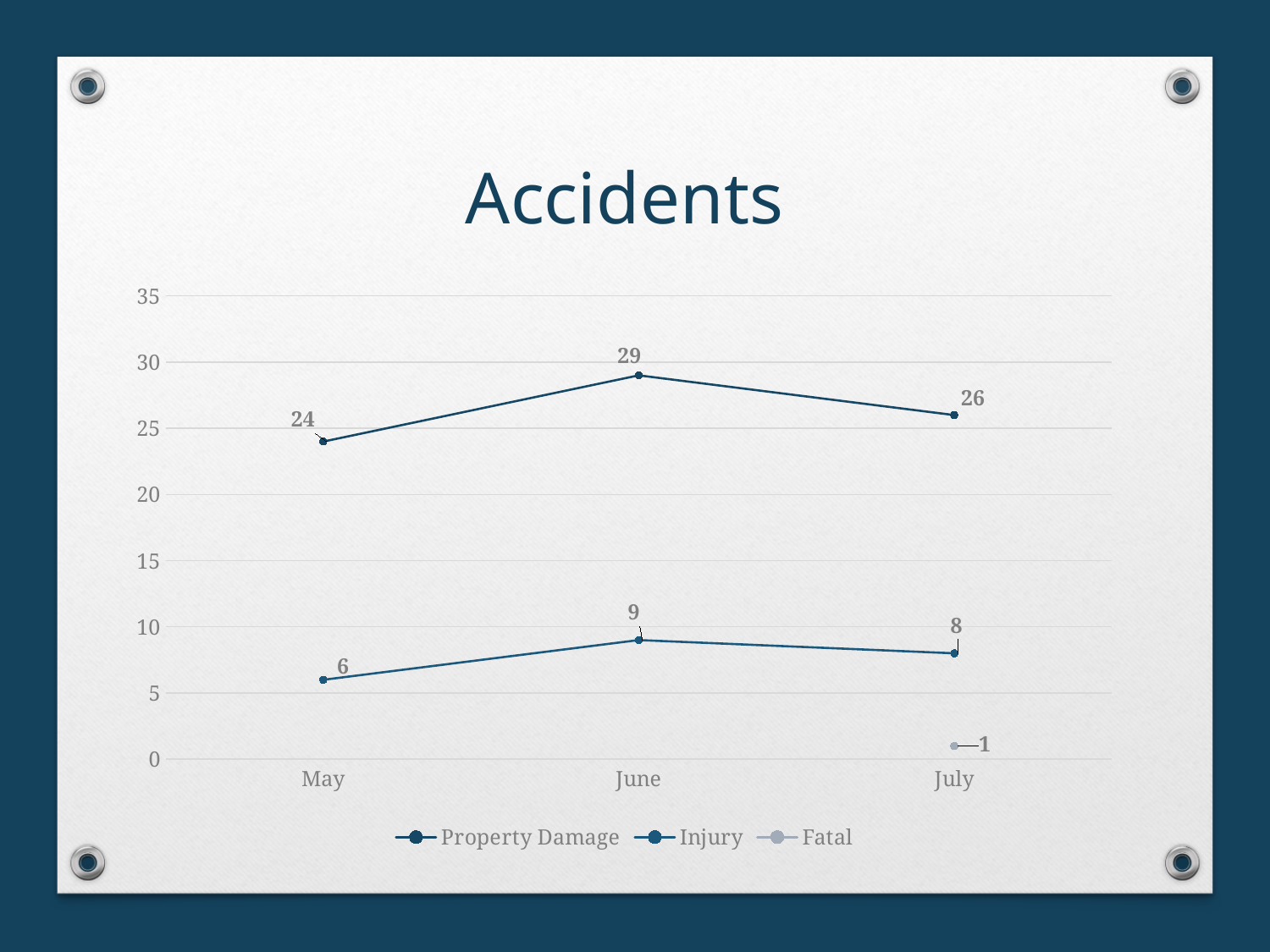
In which month is Property Damage highest? June Is the Property Damage value for July greater or less than 25? greater In which month is Injury lowest? May How many series does the legend list? 3 What is the Fatal value for July? 1 What is the Property Damage value for June? 29 What is the Injury value for May? 6 What is the title of the chart? Accidents How many months are shown on the x axis? 3 What kind of chart is shown? Line chart Which is larger: Injury in June or Injury in July? Injury in June What is the difference between Property Damage in June and in May? 5